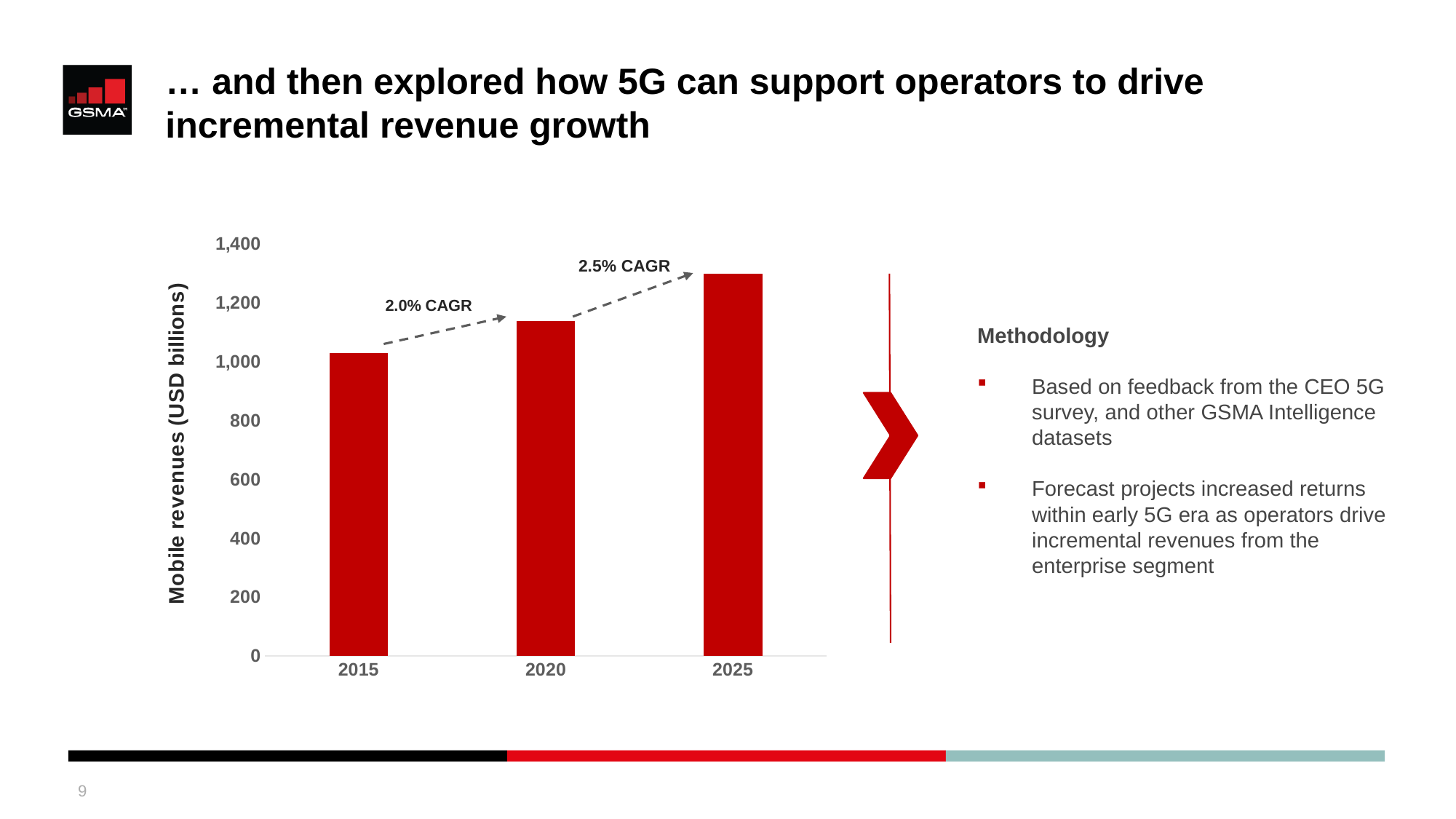
What is the label of the vertical axis of the chart? Mobile revenues (USD billions) Do mobile revenues rise or fall from 2015 to 2025 in the chart? rise What CAGR is annotated between the 2015 and 2020 bars? 2.0% CAGR Is the value for 2025 greater or less than 1,200? greater Is the value for 2015 greater or less than 1,000? greater Which year has the lowest mobile revenues in the chart? 2015 Which year has the highest mobile revenues in the chart? 2025 Which year has larger mobile revenues, 2015 or 2020? 2020 Is the value for 2020 greater or less than 1,200? less How many bars (years) are plotted in the chart? 3 What kind of chart is shown on the slide? bar chart